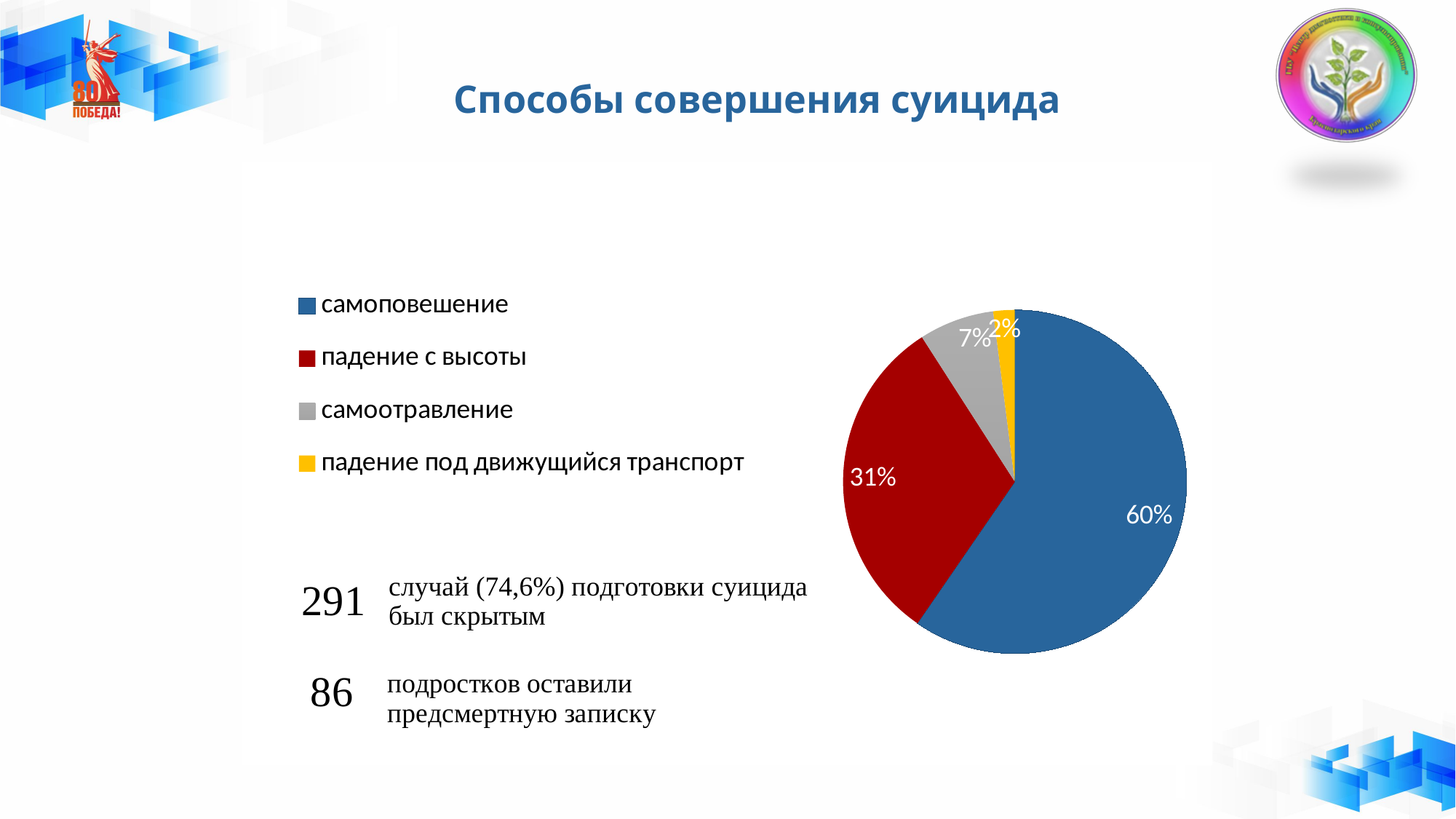
How many categories are shown in the pie chart? 4 What is the title of the slide containing the chart? Способы совершения суицида Which category has the smallest slice of the pie? падение под движущийся транспорт What share of the pie does самоотравление account for? 7% What kind of chart is shown on the slide? pie chart What colour is the slice for падение с высоты? red What share of the pie does падение с высоты account for? 31% What is the difference in percentage points between самоповешение and падение с высоты? 29 What share of the pie does самоповешение account for? 60% Which category has the largest slice of the pie? самоповешение Which is larger, the share for самоотравление or the share for падение под движущийся транспорт? самоотравление